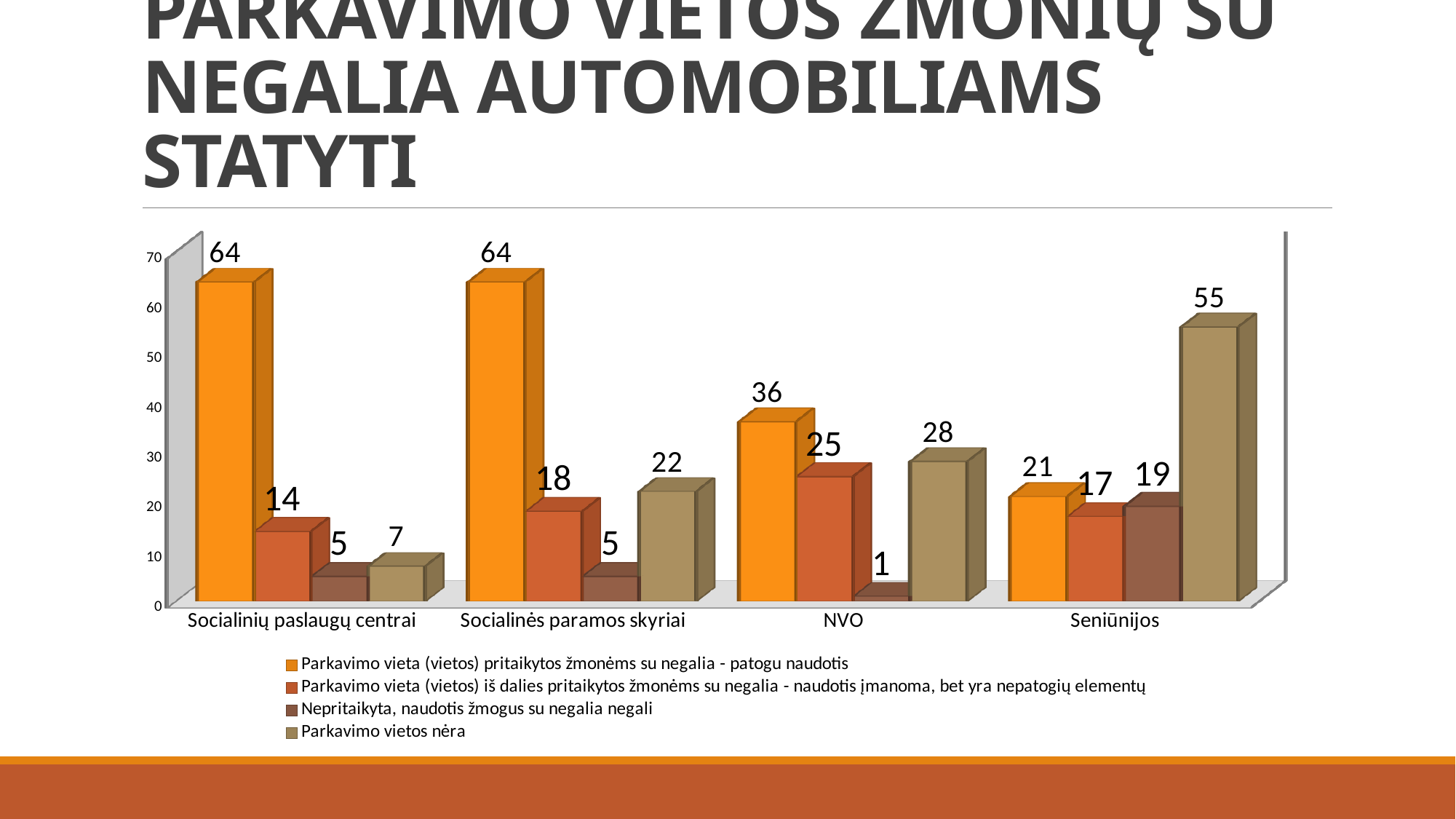
How many series does the legend list? 4 Does the value of the series "Parkavimo vieta (vietos) pritaikytos žmonėms su negalia - patogu naudotis" rise or fall from NVO to Seniūnijos? fall What kind of chart is shown on the slide? bar chart How many categories are shown on the x axis? 4 Which is larger for NVO: the "Parkavimo vieta (vietos) pritaikytos žmonėms su negalia - patogu naudotis" value or the "Parkavimo vietos nėra" value? Parkavimo vieta (vietos) pritaikytos žmonėms su negalia - patogu naudotis Is the value for Seniūnijos in the series "Parkavimo vietos nėra" greater or less than 50? greater Which category has the lowest value in the series "Nepritaikyta, naudotis žmogus su negalia negali"? NVO What is the value for Seniūnijos in the series "Nepritaikyta, naudotis žmogus su negalia negali"? 19 What is the difference between the "Parkavimo vietos nėra" values for Seniūnijos and NVO? 27 What is the value for Socialinės paramos skyriai in the series "Parkavimo vieta (vietos) iš dalies pritaikytos žmonėms su negalia - naudotis įmanoma, bet yra nepatogių elementų"? 18 Which category has the highest value in the series "Parkavimo vietos nėra"? Seniūnijos What is the value for NVO in the series "Parkavimo vietos nėra"? 28